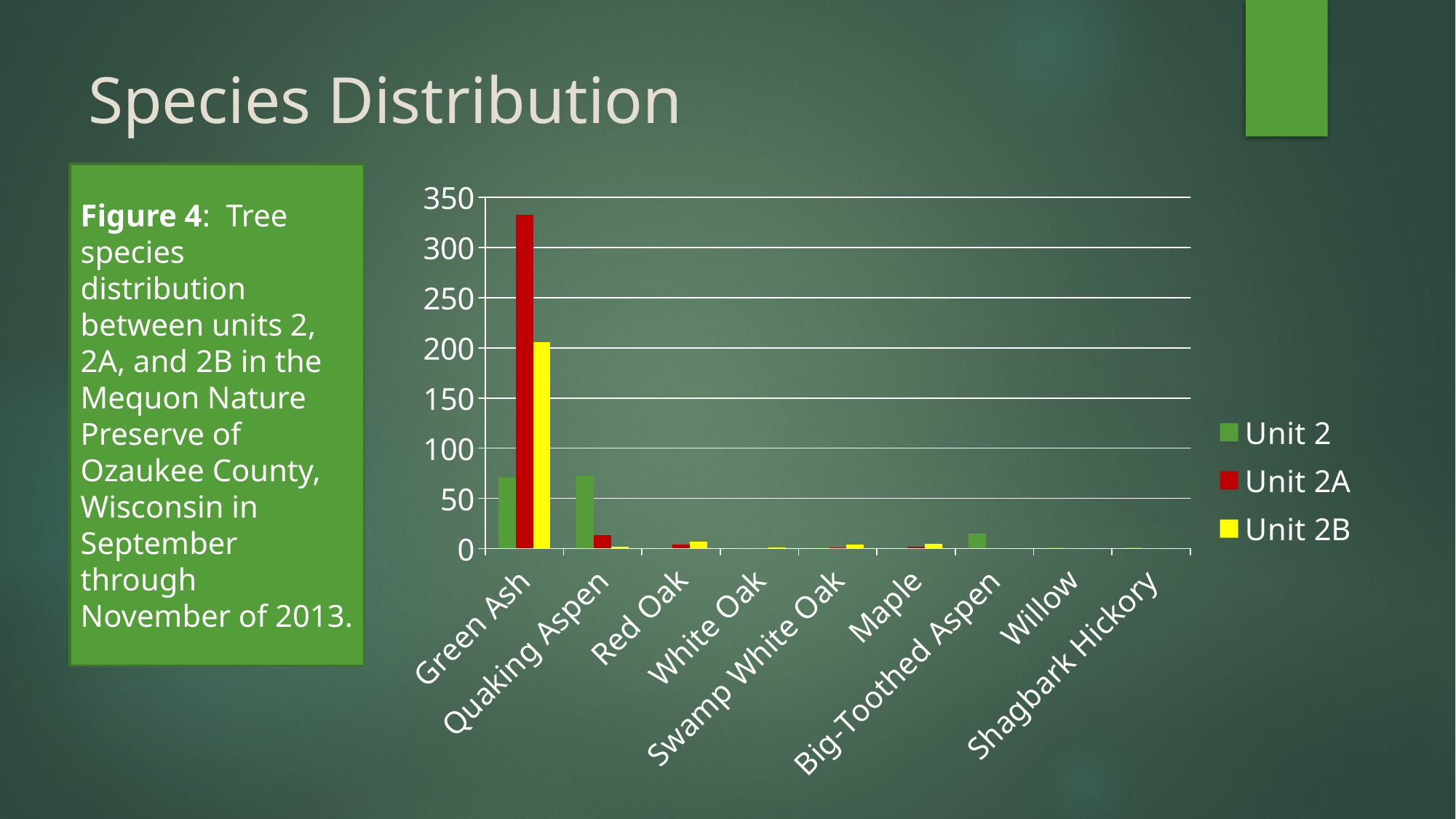
For Green Ash, which unit has the highest value? Unit 2A Is the Unit 2 value for Big-Toothed Aspen greater or less than 50? less What colour represents Unit 2B in the legend? yellow Is the Unit 2 value for Green Ash greater or less than 100? less What kind of chart is shown on the slide? bar chart For Green Ash, which is larger: the Unit 2A value or the Unit 2B value? Unit 2A For Quaking Aspen, which is larger: the Unit 2 value or the Unit 2A value? Unit 2 Which species has the highest Unit 2A value? Green Ash How many tree species categories are shown on the x axis? 9 How many series does the legend list? 3 Is the Unit 2A value for Green Ash greater or less than 300? greater